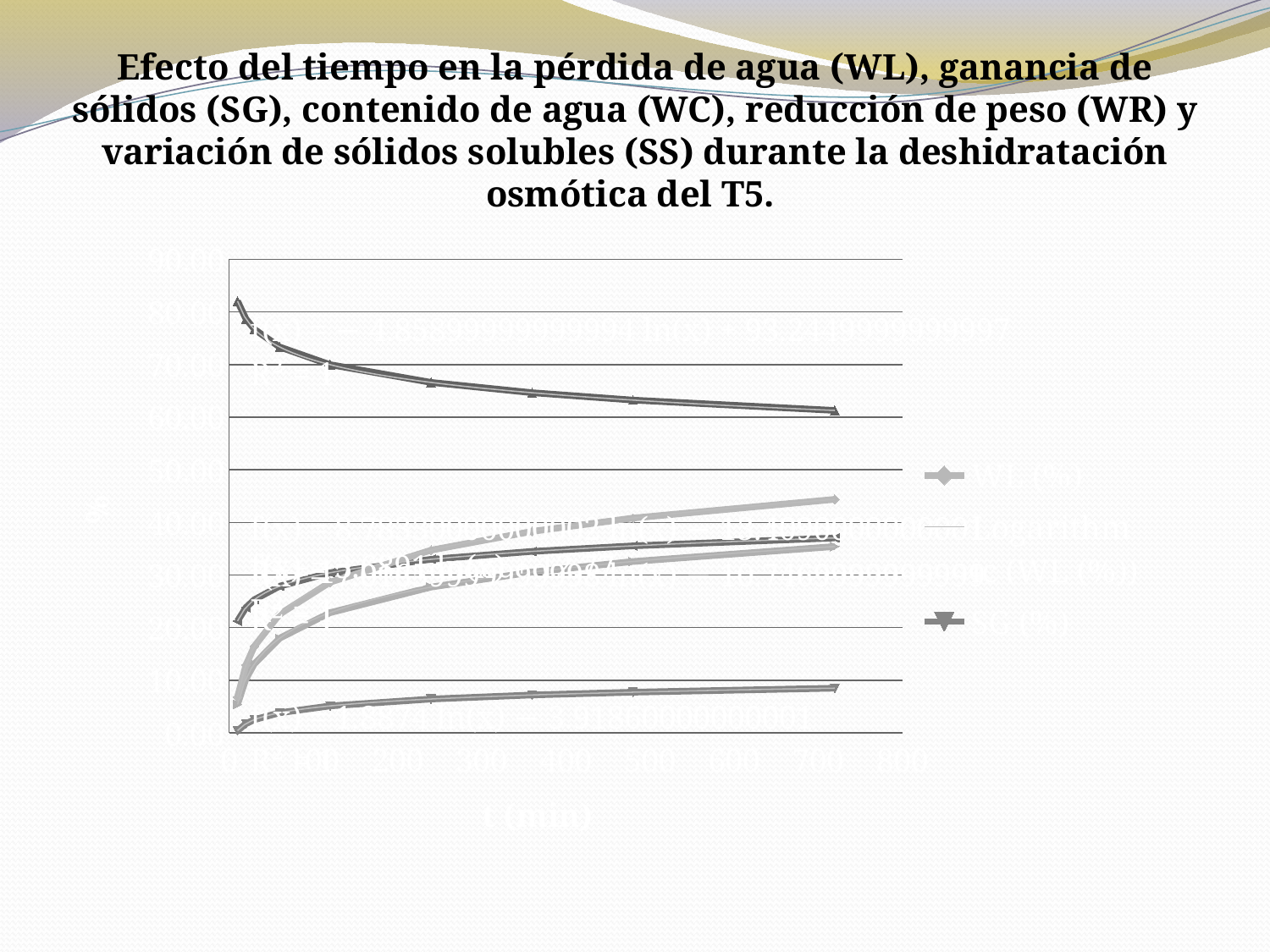
What kind of chart is shown on the slide? line chart What is the label of the x axis of the chart? t (min) Does the lowest line on the chart rise or fall as t increases? rise Is the value of the topmost line at its last plotted point (around t = 700) greater or less than 70? less Is the value of the lowest line at its last plotted point (around t = 700) greater or less than 10? less Does the line that starts near 80 on the y axis rise or fall as t increases? fall Is the value of the topmost line at its last plotted point greater or less than 50? greater At the right end of the chart, which is larger: the value of the topmost line or the value of the lowest line? the topmost line What is the highest tick value shown on the y axis of the chart? 90.00